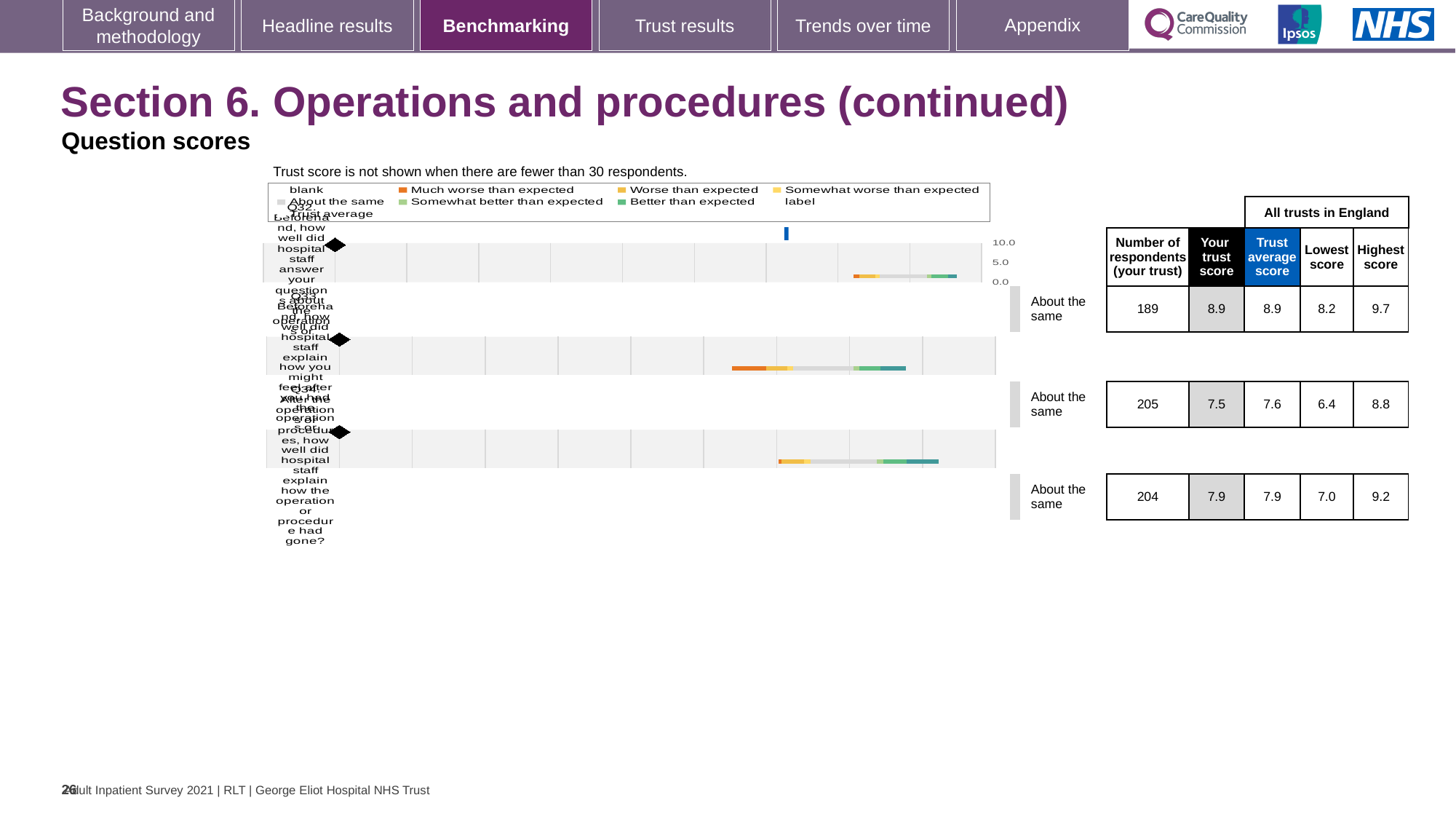
How many questions (rows) are plotted in the chart? 3 What is the lowest score across all trusts in England for the second row (Q33)? 6.4 What is the 'Your trust score' for the second row (Q33)? 7.5 Which row has the fewest respondents? The first row (Q32), 189 For the second row (Q33), which is larger: the trust score or the trust average score? Trust average score (7.6) What is the trust average score for the third row (Q34)? 7.9 For the first row (Q32), what is the difference between the highest score and the lowest score? 1.5 What is the highest score across all trusts in England for the first row (Q32)? 9.7 What kind of chart is used to show the question scores on this slide? bar chart What is the number of respondents for the first row (Q32)? 189 What benchmark category is shown next to each of the three rows? About the same Which row has the highest 'Your trust score'? The first row (Q32), 8.9